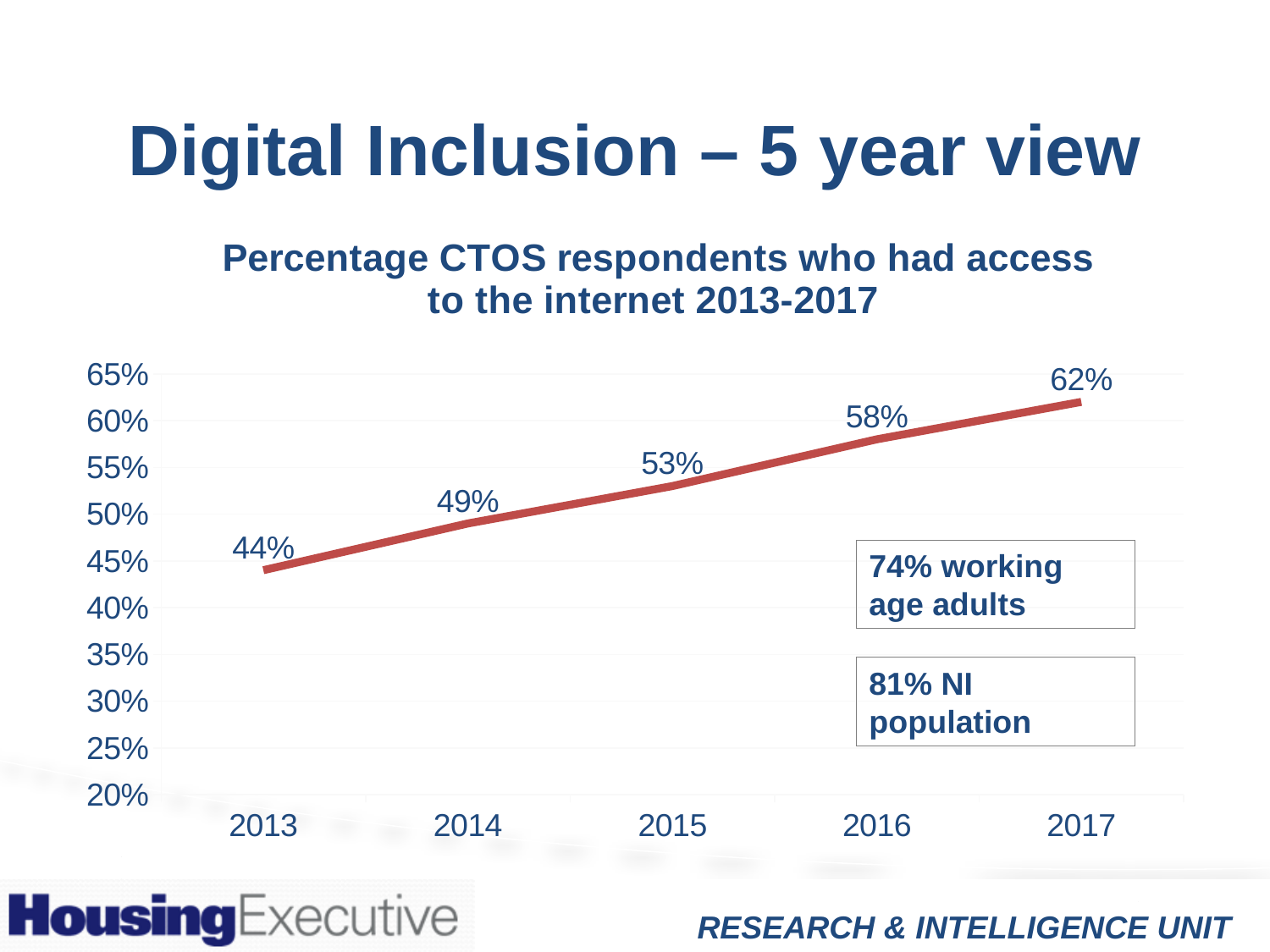
What percentage of CTOS respondents had access to the internet in 2015? 53% Do the values rise or fall from 2013 to 2017? Rise What kind of chart is shown on the slide? Line chart Which year has a higher value, 2014 or 2016? 2016 Which year has the highest percentage of respondents with internet access? 2017 What is the difference in percentage points between 2017 and 2013? 18 How many years are plotted on the chart? 5 What is the title of the chart? Percentage CTOS respondents who had access to the internet 2013-2017 What is the difference in percentage points between 2016 and 2014? 9 What percentage of CTOS respondents had access to the internet in 2013? 44% What percentage of CTOS respondents had access to the internet in 2017? 62% Which year has the lowest percentage of respondents with internet access? 2013